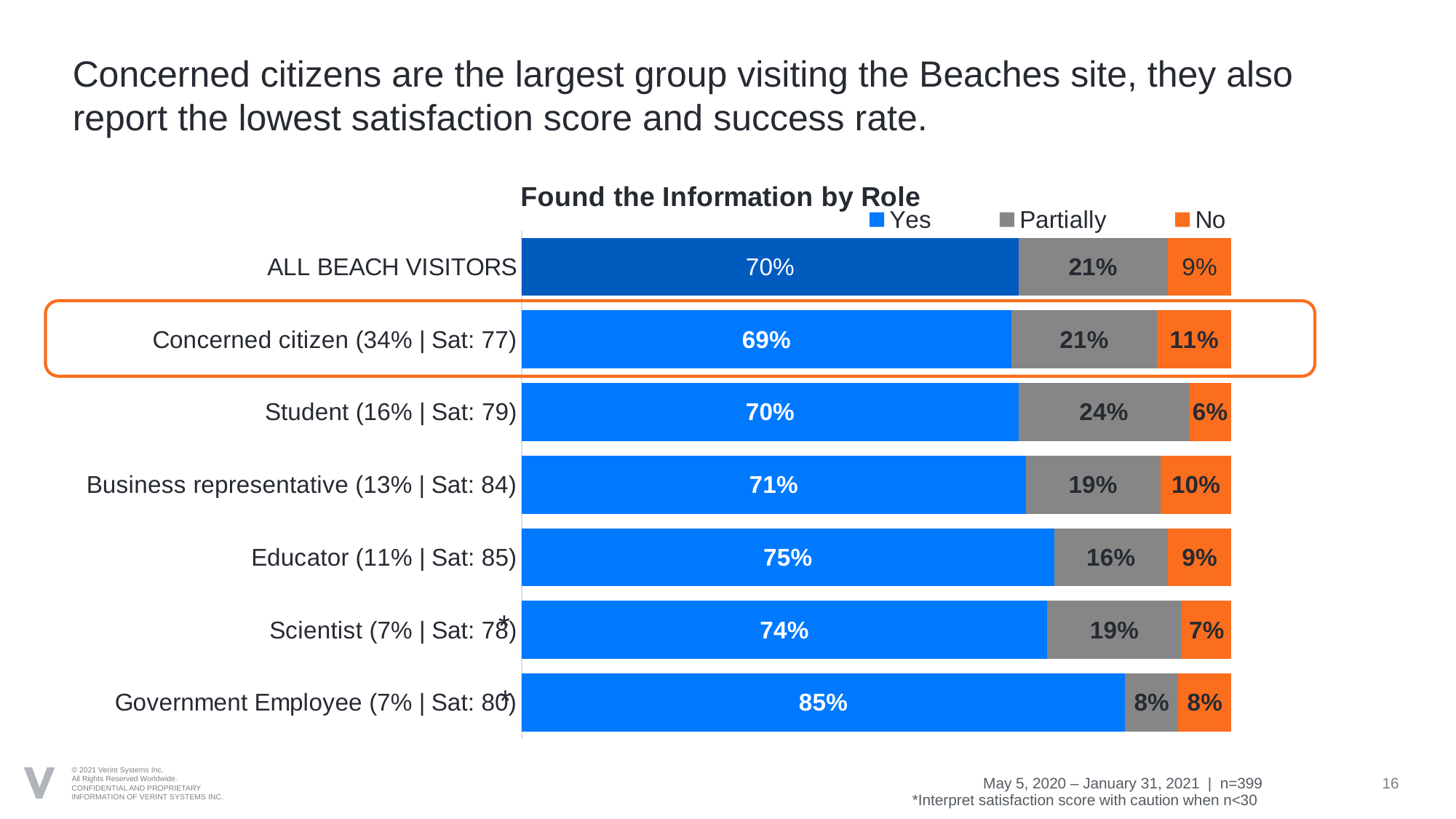
Which role has the highest No percentage in the Found the Information by Role chart? Concerned citizen Which role has the highest Yes percentage in the Found the Information by Role chart? Government Employee What is the Partially value for Students in the Found the Information by Role chart? 24% What is the No value for Government Employees in the Found the Information by Role chart? 8% Is the Partially value larger for Students or for Business representatives? Students Which role has the lowest Yes percentage in the Found the Information by Role chart? Concerned citizen What percentage of Concerned citizens answered Yes in the Found the Information by Role chart? 69% Which colour represents the No responses in the Found the Information by Role chart? Orange What type of chart is used for Found the Information by Role? Stacked bar chart How many series does the legend of the Found the Information by Role chart list? 3 What is the difference between the Yes percentage for Government Employees and for Educators? 10% How many roles (bars) are shown in the Found the Information by Role chart? 7